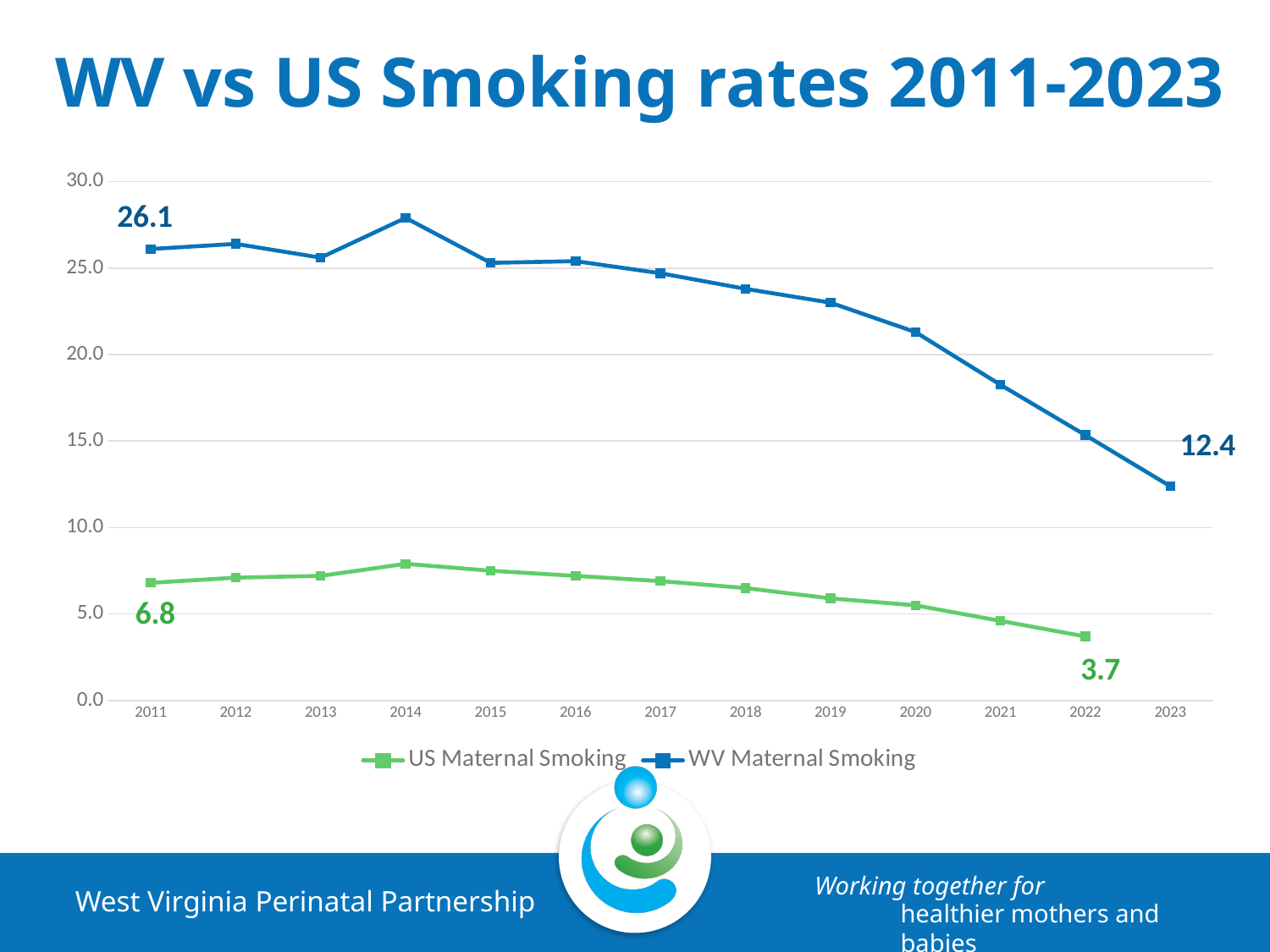
By how much did the WV Maternal Smoking rate fall from 2011 to 2023? 13.7 How many years are shown on the x axis? 13 Is the WV Maternal Smoking value for 2021 greater or less than 20.0? less What is the US Maternal Smoking rate in 2022? 3.7 What is the difference between the US Maternal Smoking rate in 2011 and in 2022? 3.1 How many series does the legend list? 2 What kind of chart is shown on the slide? Line chart What is the WV Maternal Smoking rate in 2023? 12.4 In 2011, which series has the higher value, US Maternal Smoking or WV Maternal Smoking? WV Maternal Smoking Is the WV Maternal Smoking value for 2014 greater or less than 25.0? greater What is the WV Maternal Smoking rate in 2011? 26.1 What is the US Maternal Smoking rate in 2011? 6.8